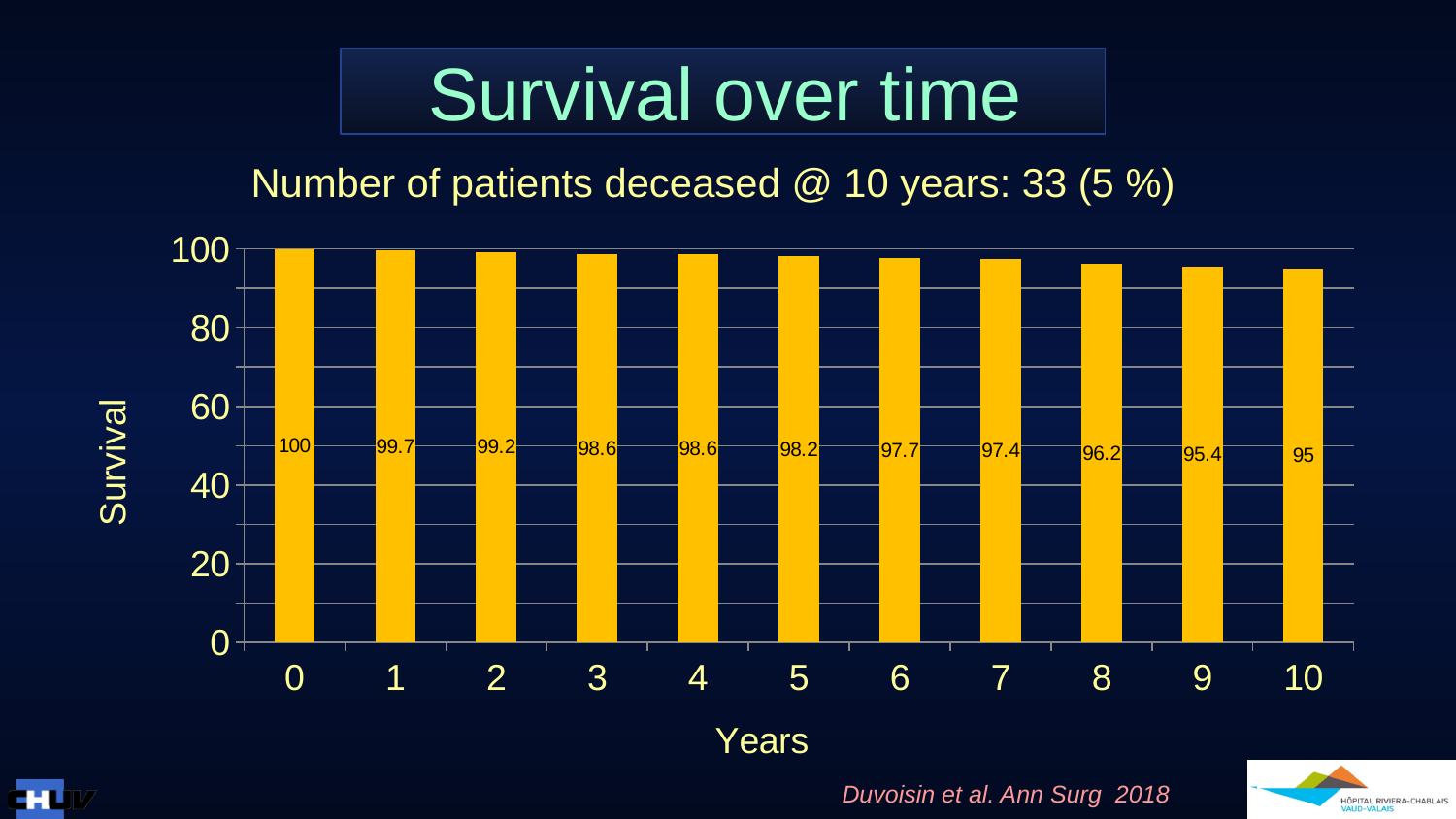
What is the survival value at year 0? 100 What is the survival value at year 8? 96.2 What is the survival value at year 10? 95 Which year has the lowest survival value? 10 What is the difference between the survival value at year 7 and at year 9? 2 Which is larger, the survival value at year 2 or at year 6? year 2 Do the survival values rise or fall as the years increase? fall Which year has the highest survival value? 0 What is the difference between the survival value at year 0 and at year 10? 5 What is the survival value at year 5? 98.2 How many years (categories) are shown on the x axis? 11 What kind of chart is shown on the slide? bar chart